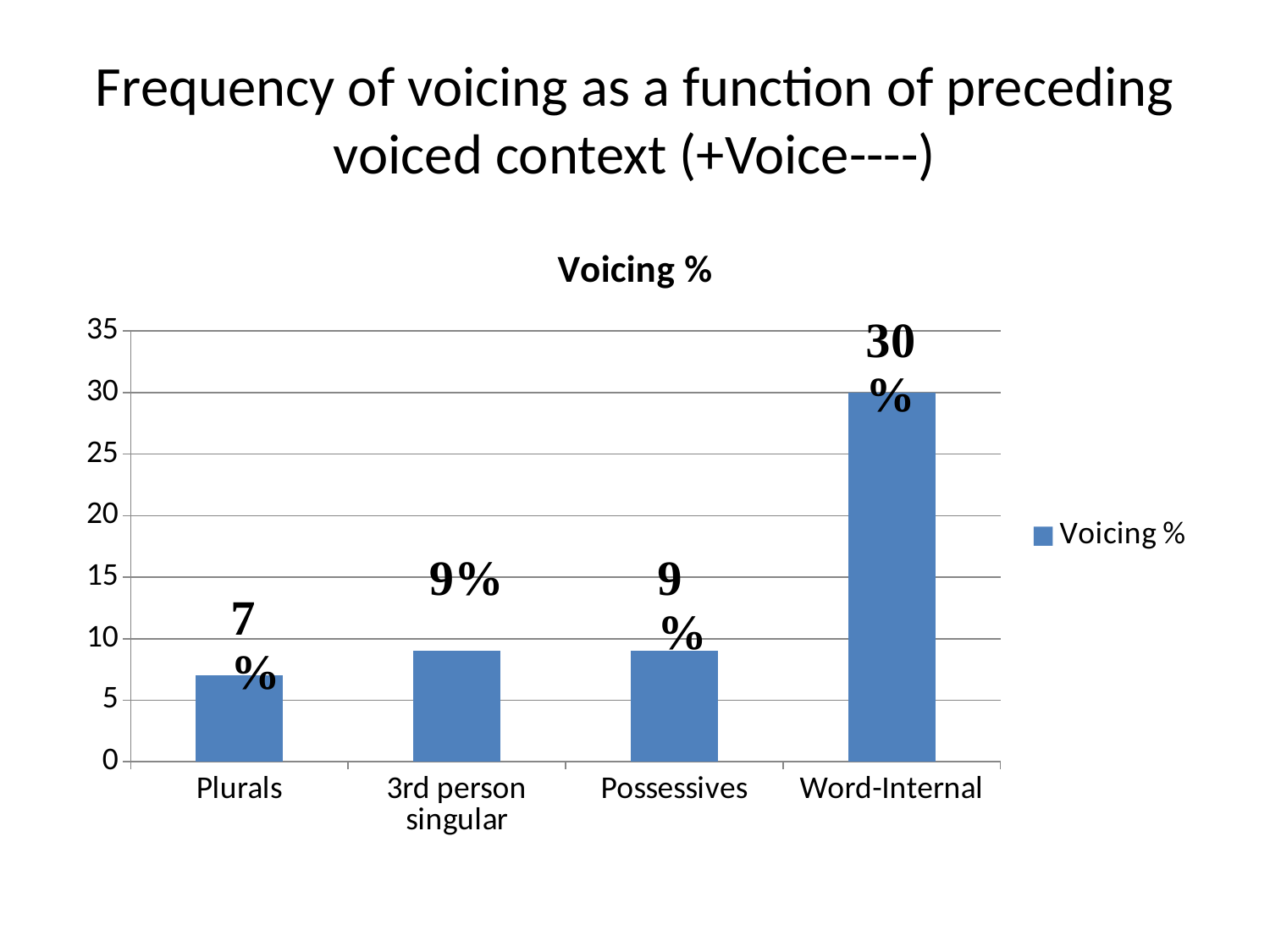
Which has a larger Voicing %, Plurals or Possessives? Possessives What is the Voicing % value for Plurals? 7% What kind of chart is shown on the slide? bar chart What is the Voicing % value for 3rd person singular? 9% Is the Voicing % for Word-Internal greater or less than 25? greater What is the difference in Voicing % between Word-Internal and Plurals? 23% How many series does the legend list? 1 Which category has the lowest Voicing %? Plurals What is the Voicing % value for Word-Internal? 30% How many categories are shown on the x axis? 4 What is the difference in Voicing % between Possessives and Plurals? 2% Which category has the highest Voicing %? Word-Internal